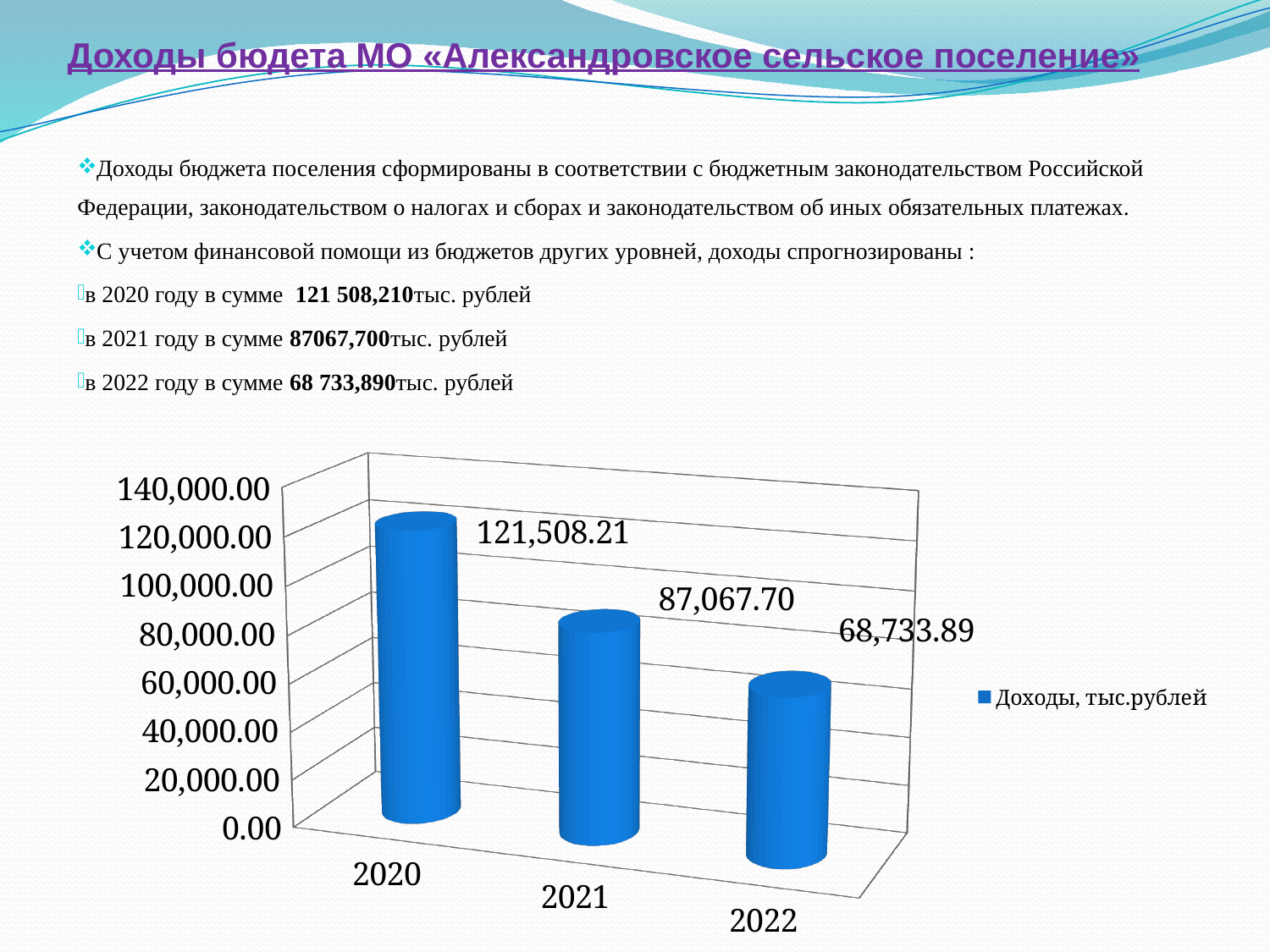
Which year has the lowest value? 2022 What is the difference between the values for 2021 and 2022? 18,333.81 What is the value shown for 2021? 87,067.70 Is the value for 2022 greater or less than 80,000.00? less How many years are shown on the x axis? 3 What is the value shown for 2022? 68,733.89 Which is larger, the value for 2021 or the value for 2022? 2021 Which year has the highest value? 2020 What is the value shown for 2020? 121,508.21 Do the values rise or fall from 2020 to 2022? fall What kind of chart is shown on the slide? bar chart What is the difference between the values for 2020 and 2021? 34,440.51